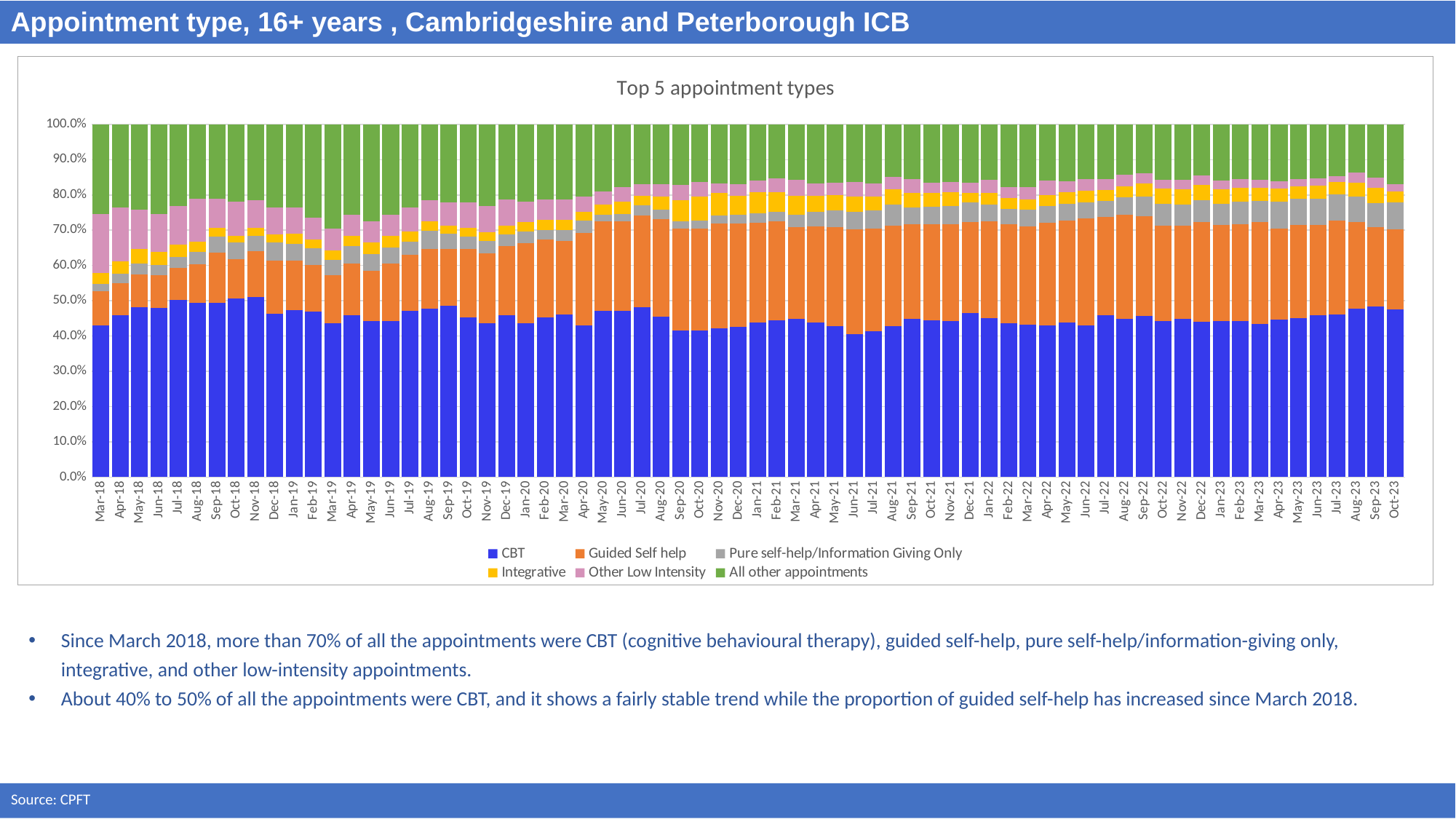
Is the CBT share for Oct-23 greater or less than 50.0%? less Which series is shown in blue in the legend? CBT What is the total of each stacked bar in the chart? 100.0% Is the CBT share for Jun-21 greater or less than 50.0%? less What kind of chart is shown on the slide? Stacked bar chart How many months are plotted along the x axis, from Mar-18 to Oct-23? 68 Is the CBT share for Mar-18 greater or less than 40.0%? greater What is the first month shown on the x axis? Mar-18 What is the title of the chart? Top 5 appointment types Does the share of Guided Self help rise or fall from Mar-18 to Oct-23? rise Does the share of Other Low Intensity appointments rise or fall from Mar-18 to Oct-23? fall How many series does the legend list? 6